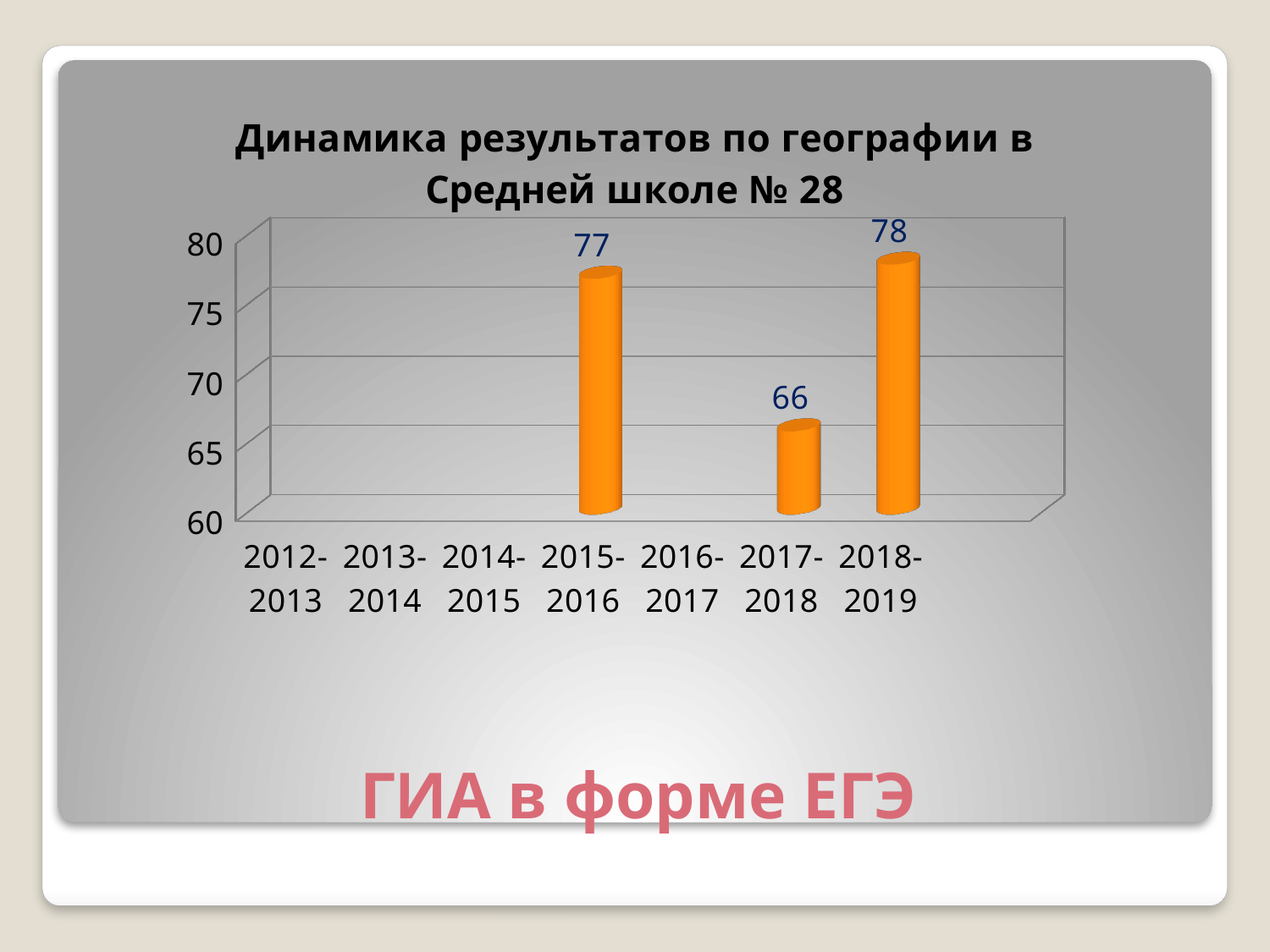
What is the value for 2015-2016? 77 What kind of chart is shown on the slide? bar chart How many categories are shown on the x axis? 7 What is the value for 2018-2019? 78 Which is larger, the value for 2015-2016 or the value for 2017-2018? 2015-2016 Which year with a plotted bar has the lowest value? 2017-2018 What is the difference between the values for 2018-2019 and 2017-2018? 12 Is the value for 2017-2018 greater or less than 70? less Which year has the highest value? 2018-2019 What is the title of the chart? Динамика результатов по географии в Средней школе № 28 What is the value for 2017-2018? 66 What is the difference between the values for 2015-2016 and 2017-2018? 11